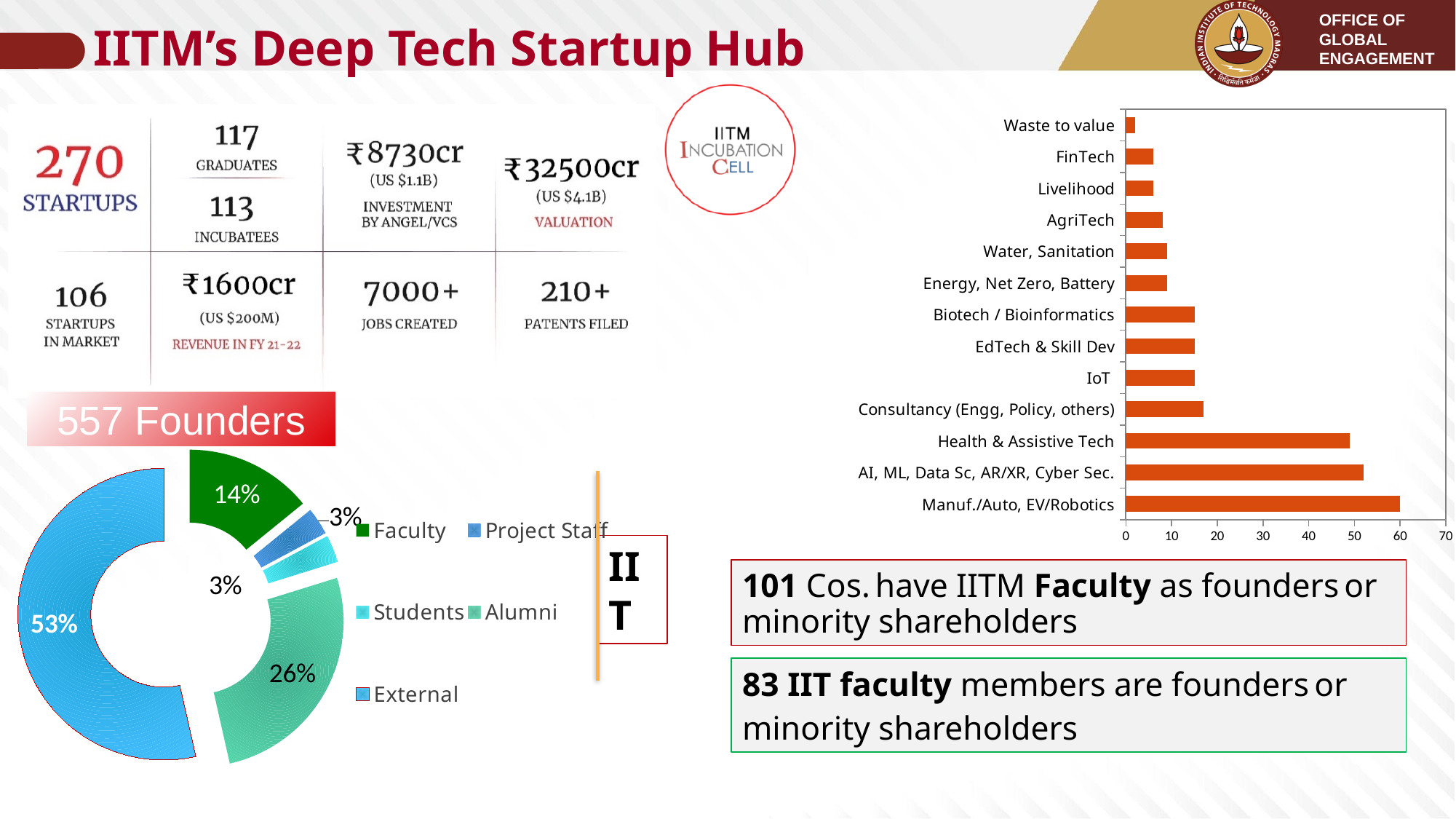
In the bar chart on the right, is the value for Waste to value greater or less than 10? less In the 557 Founders doughnut chart, which category has the largest share? External In the bar chart on the right, is the value for Health & Assistive Tech greater or less than 40? greater How many categories does the 557 Founders doughnut chart's legend list? 5 In the 557 Founders doughnut chart, what is the difference between the External and Alumni shares? 27% In the bar chart on the right, which sector has the longest bar? Manuf./Auto, EV/Robotics In the bar chart on the right, which sector has the shortest bar? Waste to value In the 557 Founders doughnut chart, what share of founders is External? 53% In the 557 Founders doughnut chart, what share of founders is Faculty? 14% How many sectors are shown in the bar chart on the right? 13 In the 557 Founders doughnut chart, what share of founders is Alumni? 26% In the 557 Founders doughnut chart, which is larger, the Faculty share or the Alumni share? Alumni